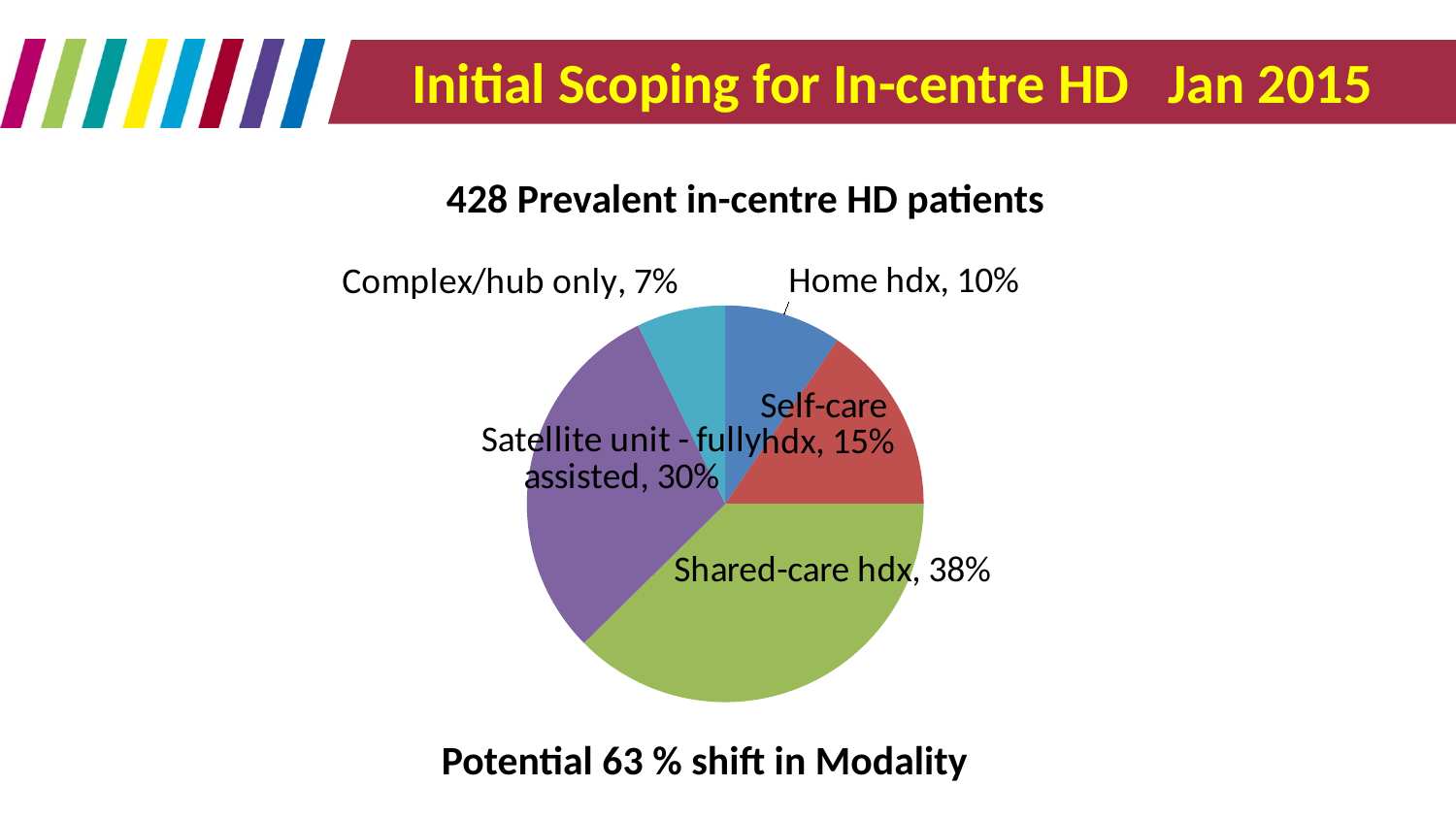
What colour is the Shared-care hdx slice? green What share of the pie is Home hdx? 10% What share of the pie is Complex/hub only? 7% What is the chart's title? 428 Prevalent in-centre HD patients What kind of chart is shown on the slide? pie chart What share of the pie is Shared-care hdx? 38% What is the difference in percentage points between Shared-care hdx and Satellite unit - fully assisted? 8 Which category has the smallest slice of the pie? Complex/hub only How many slices does the pie chart have? 5 Which category has the largest slice of the pie? Shared-care hdx Which is larger, Self-care hdx or Home hdx? Self-care hdx